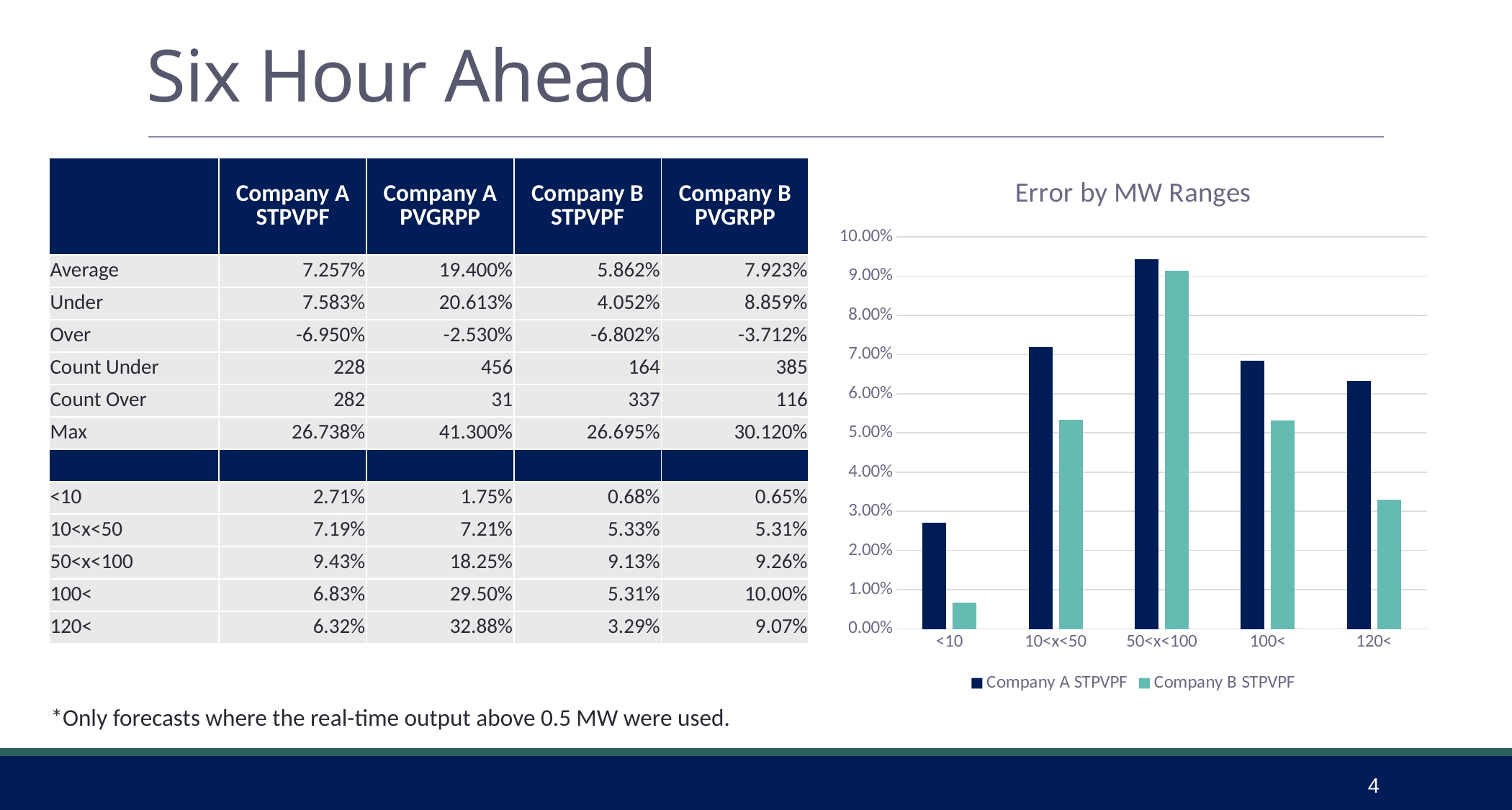
How many series does the legend of the "Error by MW Ranges" chart list? 2 In the "Error by MW Ranges" chart, is the value for Company A STPVPF at 10<x<50 greater or less than 6.00%? greater In the "Error by MW Ranges" chart, which MW range has the highest value for Company A STPVPF? 50<x<100 What is the title of the chart on the slide? Error by MW Ranges In the "Error by MW Ranges" chart, which MW range has the lowest value for Company B STPVPF? <10 In the "Error by MW Ranges" chart, is the value for Company B STPVPF at <10 greater or less than 1.00%? less What kind of chart is "Error by MW Ranges"? bar chart In the "Error by MW Ranges" chart, is the value for Company B STPVPF at 120< greater or less than 4.00%? less In the "Error by MW Ranges" chart, do the Company B STPVPF values rise or fall from 50<x<100 to 120<? fall In the "Error by MW Ranges" chart, which series has the larger value at 100<, Company A STPVPF or Company B STPVPF? Company A STPVPF How many MW range categories are shown on the x axis of the "Error by MW Ranges" chart? 5 Which two series are listed in the legend of the "Error by MW Ranges" chart? Company A STPVPF and Company B STPVPF